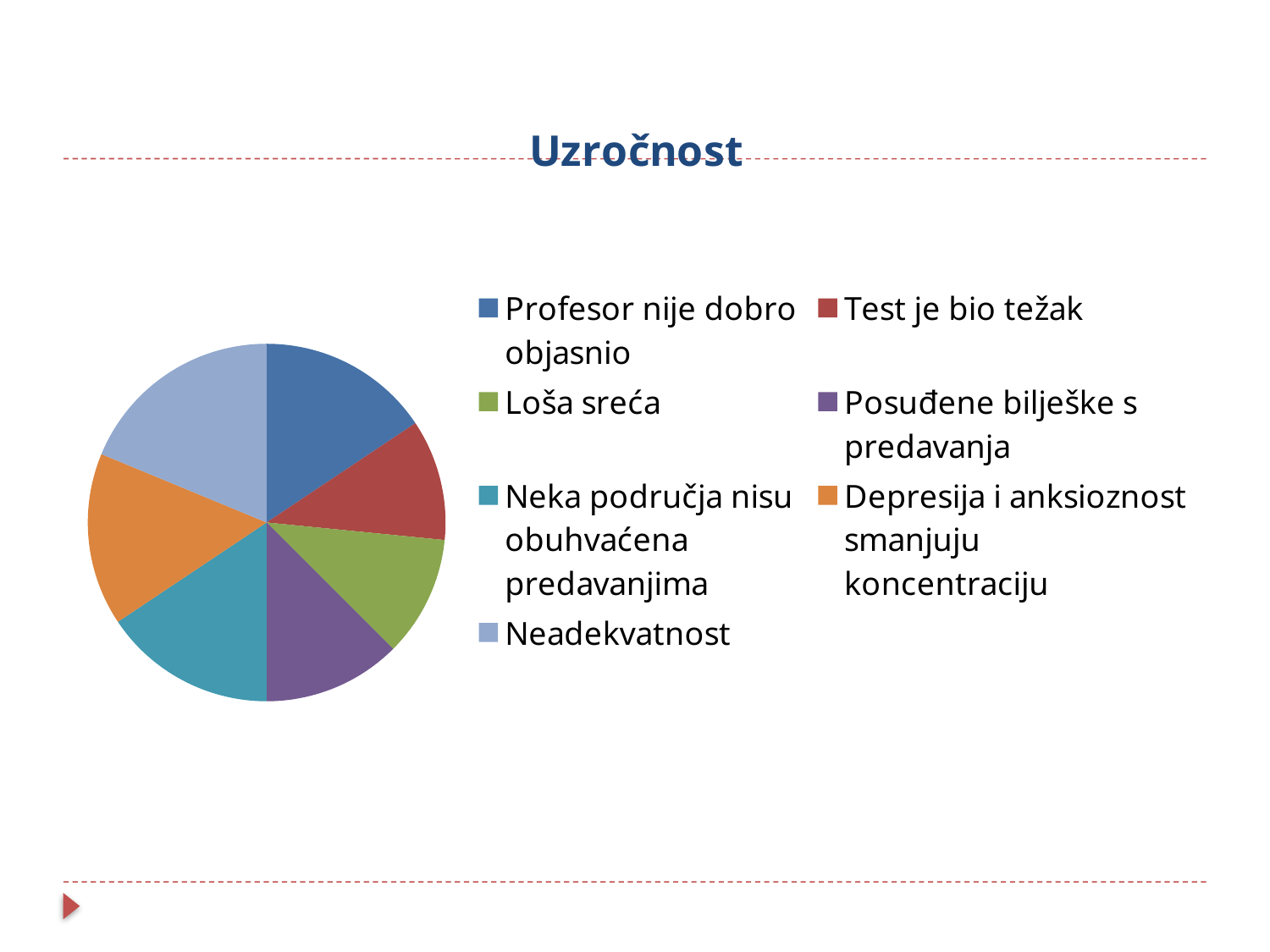
Which slice is larger, "Depresija i anksioznost smanjuju koncentraciju" or "Posuđene bilješke s predavanja"? Depresija i anksioznost smanjuju koncentraciju Which category has the largest slice in the pie chart? Neadekvatnost How many slices does the pie chart have? 7 What kind of chart is shown on the slide? pie chart What is the title of the slide containing the pie chart? Uzročnost Which slice is larger, "Profesor nije dobro objasnio" or "Loša sreća"? Profesor nije dobro objasnio How many entries does the legend of the pie chart list? 7 What colour is the slice for "Depresija i anksioznost smanjuju koncentraciju" in the pie chart? orange Which slice is larger, "Neadekvatnost" or "Test je bio težak"? Neadekvatnost